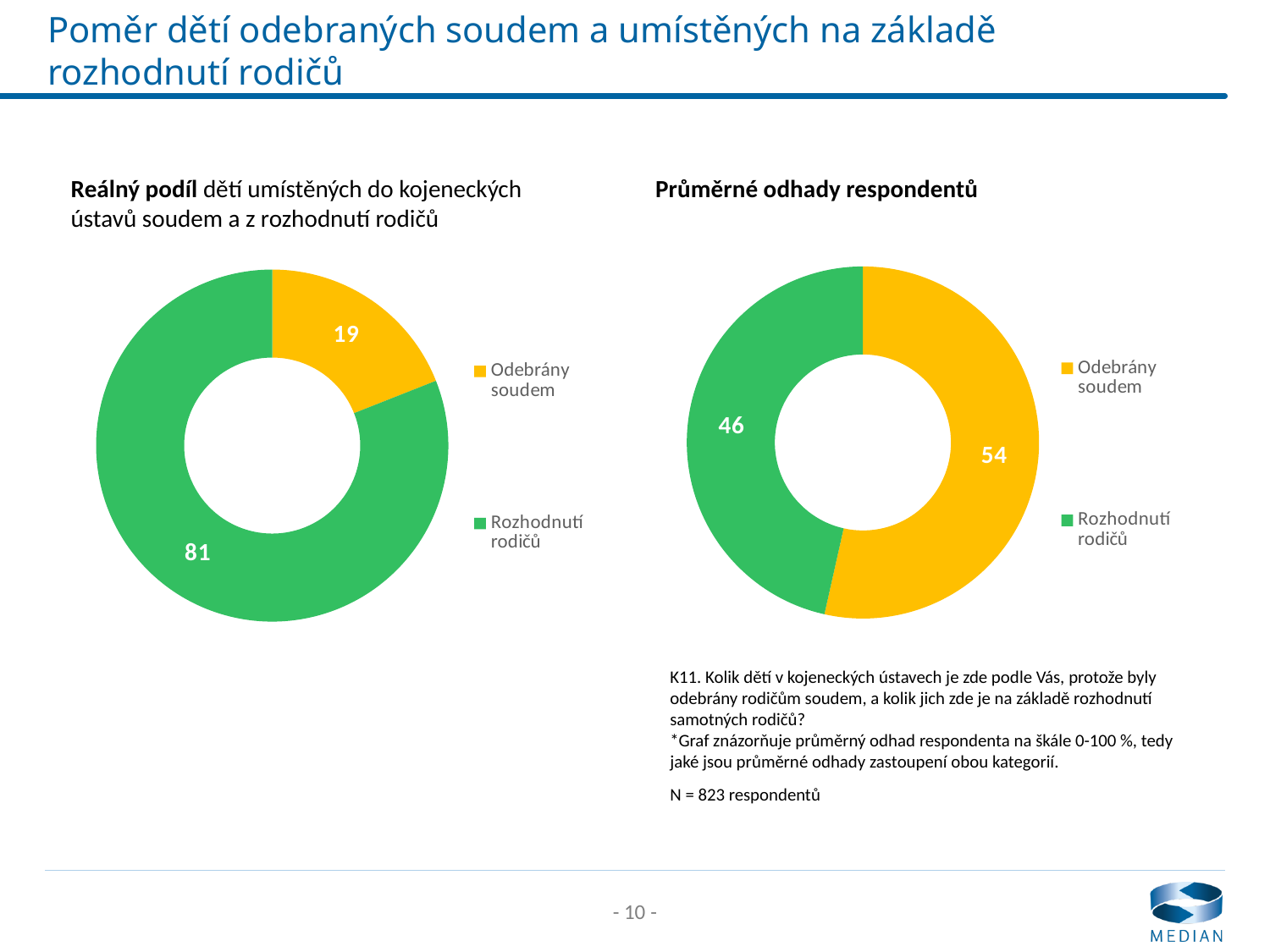
In the right chart (Průměrné odhady respondentů), what is the difference between Odebrány soudem and Rozhodnutí rodičů? 8 In the left chart (Reálný podíl), what is the difference between Rozhodnutí rodičů and Odebrány soudem? 62 Which is larger: the value for Odebrány soudem in the left chart or in the right chart? Right chart (Průměrné odhady respondentů) In the right chart (Průměrné odhady respondentů), what is the value for Odebrány soudem? 54 In the right chart (Průměrné odhady respondentů), which colour represents Odebrány soudem? Yellow How many categories does the legend of the left chart (Reálný podíl) list? 2 What type of chart is used on this slide? Doughnut chart In the right chart (Průměrné odhady respondentů), what is the value for Rozhodnutí rodičů? 46 In the left chart (Reálný podíl), which category has the largest share? Rozhodnutí rodičů In the left chart (Reálný podíl), what is the value for Odebrány soudem? 19 In the left chart (Reálný podíl), what is the value for Rozhodnutí rodičů? 81 In the right chart (Průměrné odhady respondentů), which category has the smallest share? Rozhodnutí rodičů